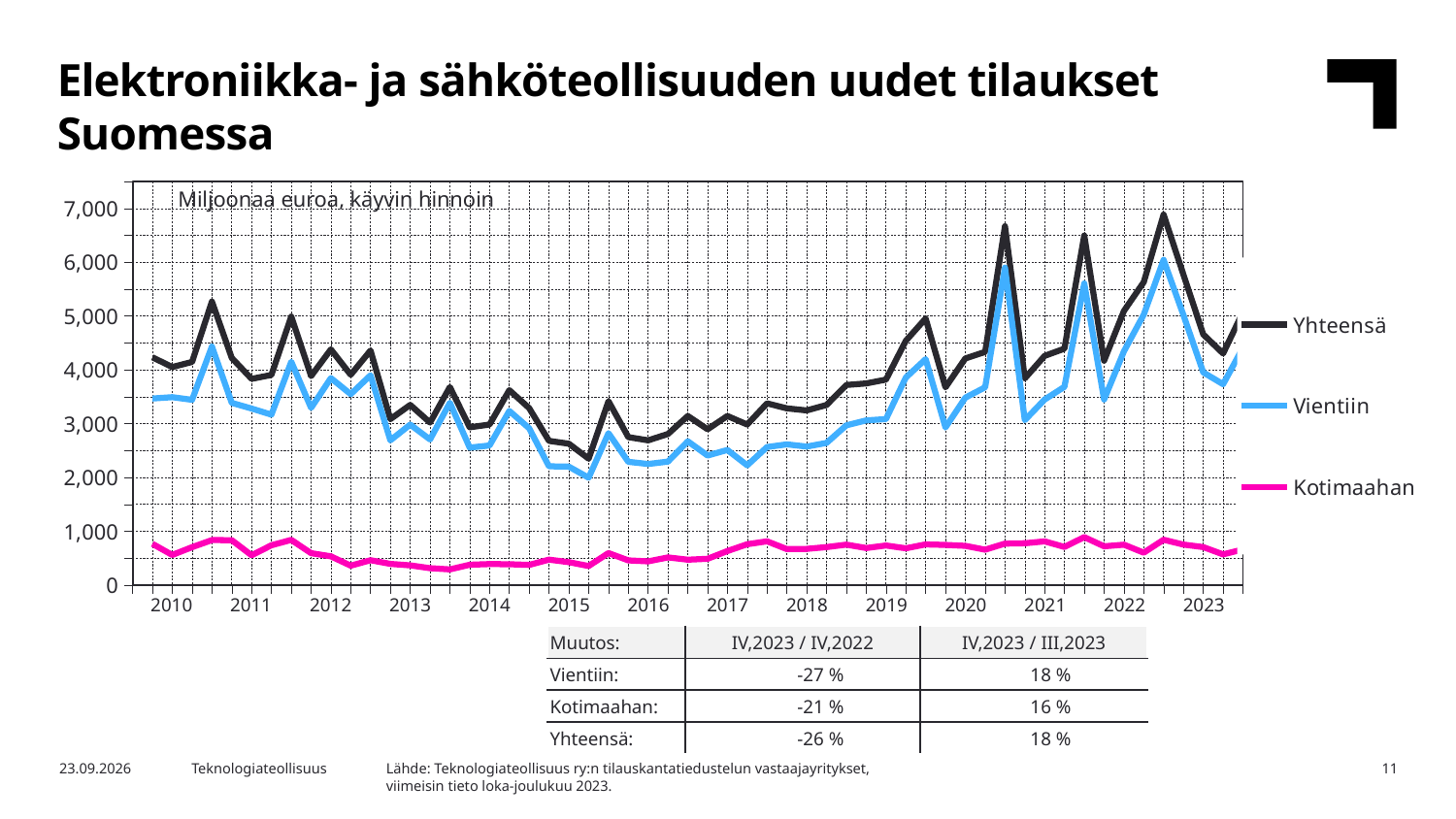
Is the value for Kotimaahan in 2015 greater or less than 1,000? less How many year labels are shown on the x axis? 14 How many series does the legend list? 3 Which series has the lowest values throughout the chart? Kotimaahan What kind of chart is shown on the slide? line chart Is the value for Vientiin at the start of 2015 greater or less than 3,000? less Which series has the highest values throughout the chart? Yhteensä Is the peak value for Yhteensä in 2022 greater or less than 6,000? greater What unit is stated at the top of the chart area? Miljoonaa euroa, käyvin hinnoin Between 2010 and 2015, does the Yhteensä series generally rise or fall? fall Which of the two series is larger in 2020, Vientiin or Kotimaahan? Vientiin What is the title of the chart? Elektroniikka- ja sähköteollisuuden uudet tilaukset Suomessa